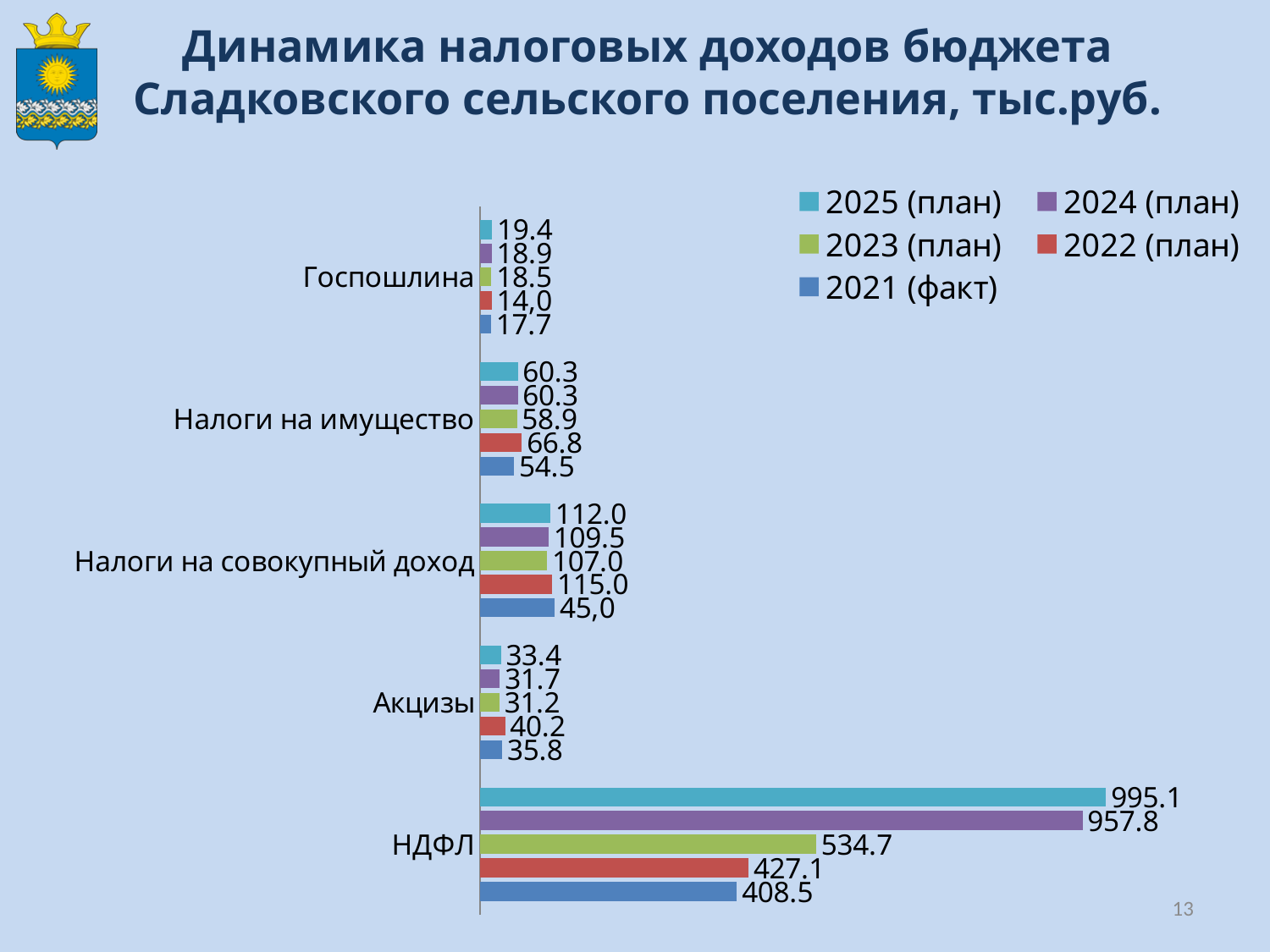
Which legend entry is marked as actual (факт) rather than planned? 2021 (факт) What is the 2025 (план) value for НДФЛ? 995.1 What is the 2022 (план) value for Госпошлина? 14,0 What is the difference between the 2025 (план) and 2021 (факт) values for НДФЛ? 586.6 What is the 2023 (план) value for Акцизы? 31.2 How many series does the legend list? 5 Which is larger for Налоги на имущество: the 2022 (план) value or the 2023 (план) value? 2022 (план) Which category has the highest 2024 (план) value? НДФЛ What kind of chart is shown on the slide? Bar chart Which category has the lowest 2021 (факт) value? Госпошлина How many categories are shown on the chart? 5 What is the 2021 (факт) value for Налоги на совокупный доход? 45,0